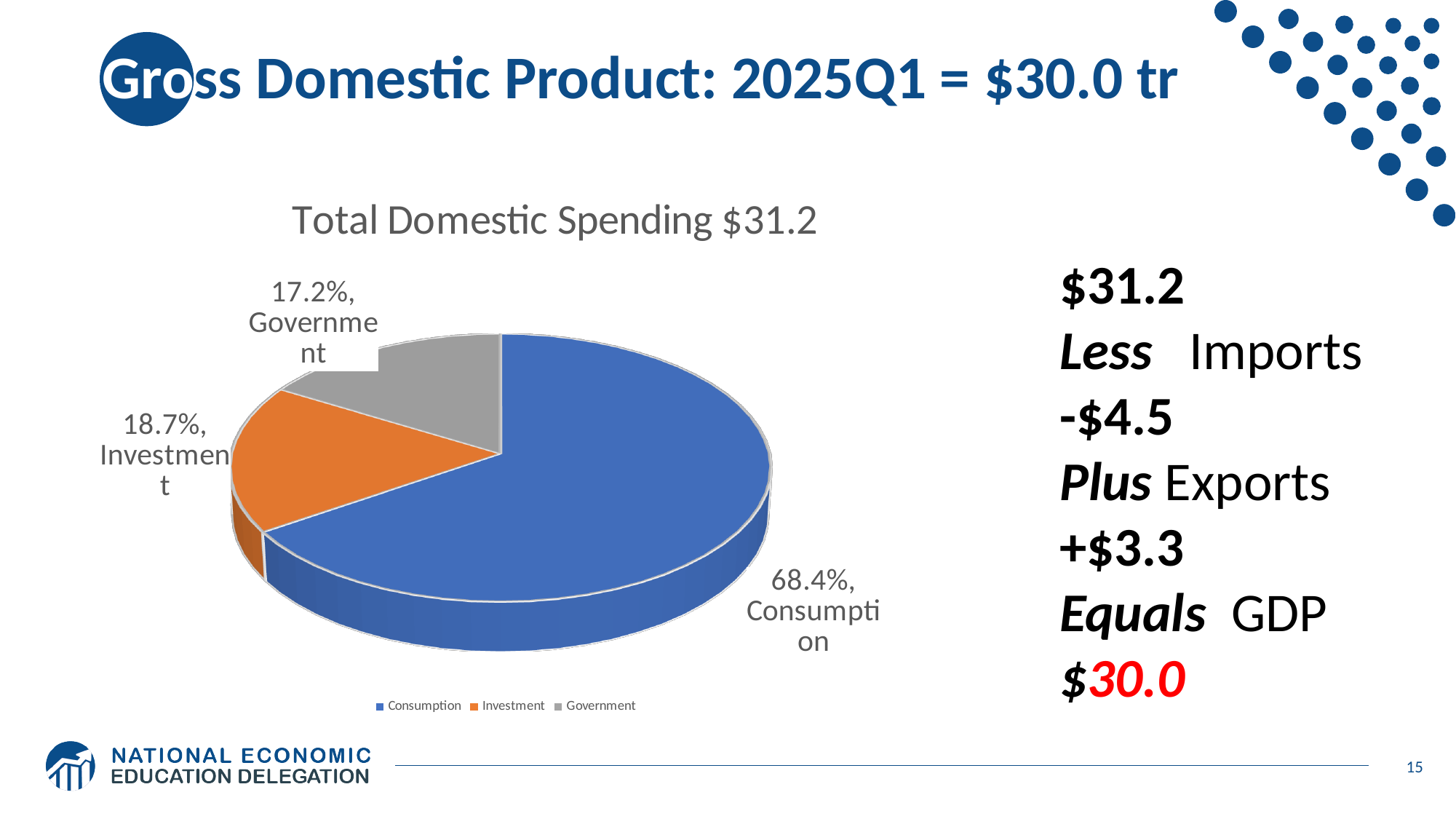
What is the difference in percentage points between the Consumption and Investment shares? 49.7 What share of the pie does Consumption represent? 68.4% Which colour represents Government in the pie chart? grey What kind of chart is shown on the slide? pie chart How many entries does the legend list? 3 Which category has the largest slice of the pie? Consumption What is the difference in percentage points between the Investment and Government shares? 1.5 Which category has the smallest slice of the pie? Government What is the title of the chart? Total Domestic Spending $31.2 What share of the pie does Investment represent? 18.7% What share of the pie does Government represent? 17.2% How many slices does the pie chart have? 3